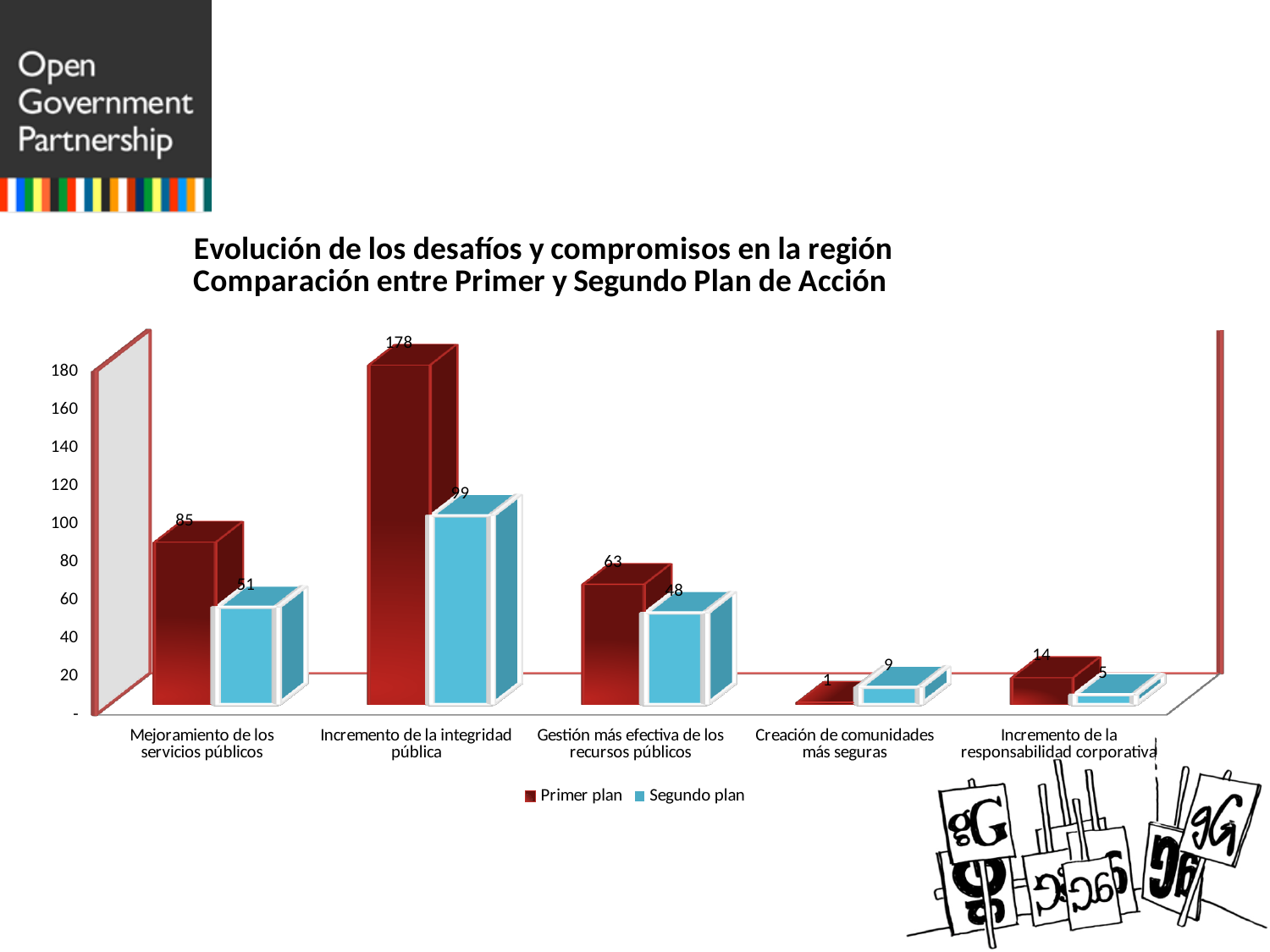
Which is larger for Creación de comunidades más seguras: the Primer plan value or the Segundo plan value? Segundo plan What is the value for Primer plan in the category Mejoramiento de los servicios públicos? 85 How many series does the legend list? 2 What is the value for Segundo plan in the category Creación de comunidades más seguras? 9 What kind of chart is shown on the slide? Bar chart What is the value for Segundo plan in the category Gestión más efectiva de los recursos públicos? 48 Which colour represents the Segundo plan series? Light blue Which category has the lowest value for Segundo plan? Incremento de la responsabilidad corporativa Which category has the highest value for Primer plan? Incremento de la integridad pública How many categories are shown on the x axis? 5 What is the value for Primer plan in the category Incremento de la integridad pública? 178 What is the difference between the Primer plan and Segundo plan values for Incremento de la integridad pública? 79